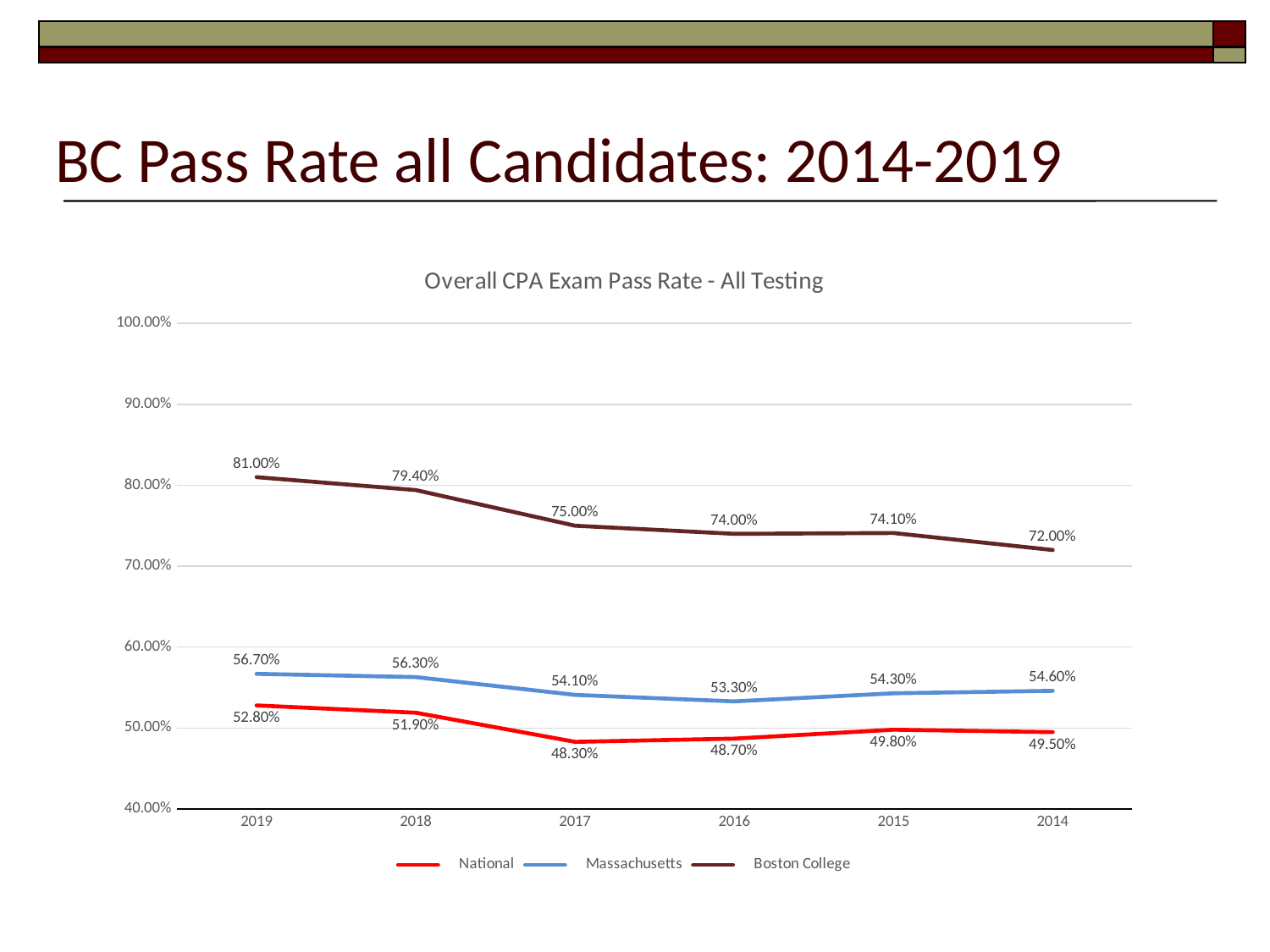
What kind of chart is shown on the slide? line chart What is the Boston College pass rate for 2019? 81.00% In which year is the Boston College pass rate highest? 2019 Does the Boston College line rise or fall moving from left (2019) to right (2014) along the x axis? fall In which year is the National pass rate lowest? 2017 What is the Massachusetts pass rate for 2016? 53.30% Is the Boston College pass rate for 2018 greater or less than 70.00%? greater What is the National pass rate for 2017? 48.30% How many series does the legend list? 3 What is the difference between the Boston College and National pass rates in 2014? 22.50% Which is larger in 2015: the Massachusetts pass rate or the National pass rate? Massachusetts How many years are shown on the x axis? 6